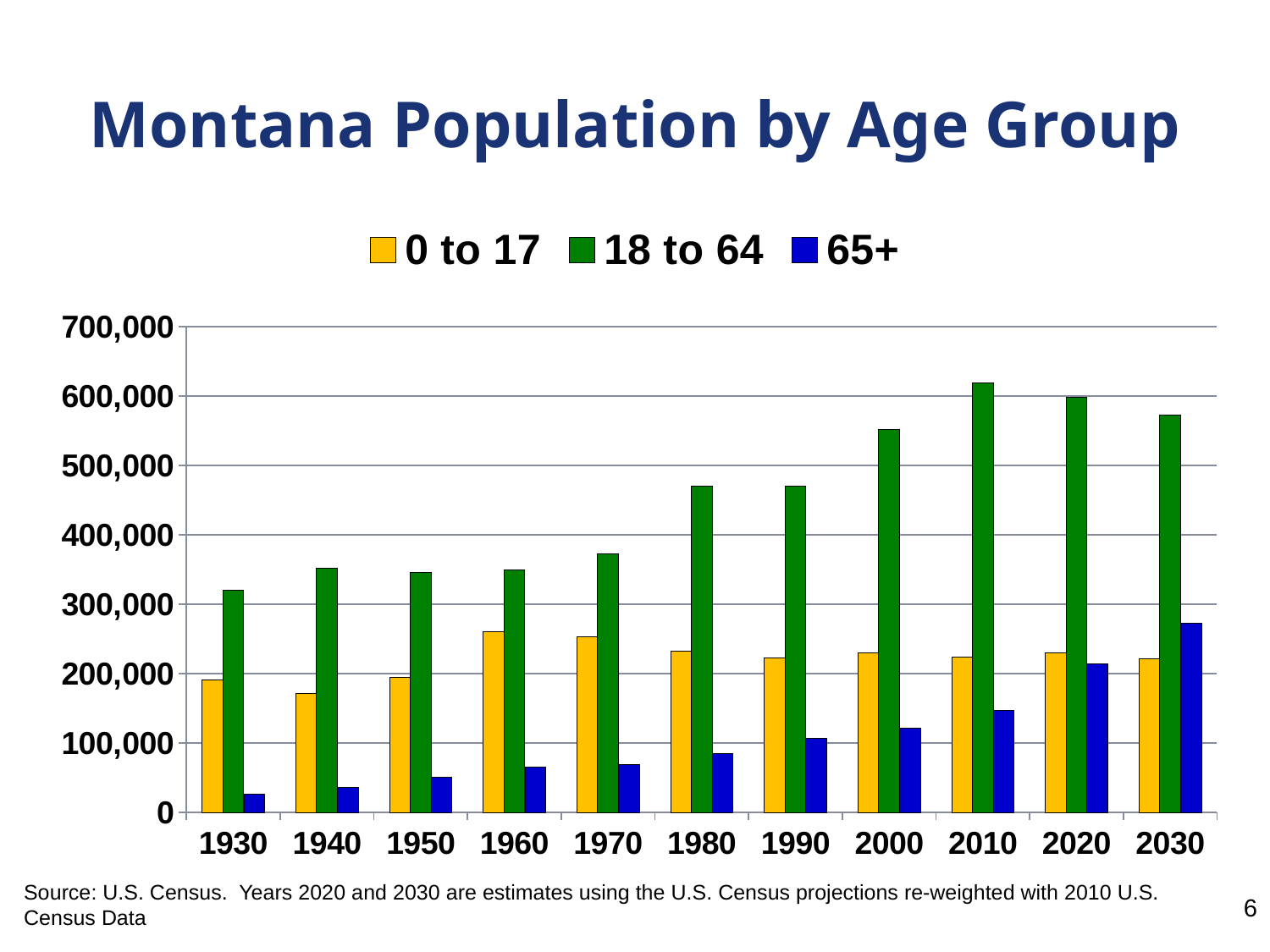
What kind of chart is shown on the slide? bar chart In which year is the 65+ population lowest? 1930 In which year is the 0 to 17 population lowest? 1940 How many years are shown along the x axis? 11 In 1930, which is larger: the 0 to 17 population or the 18 to 64 population? 18 to 64 What is the title of the chart? Montana Population by Age Group Is the 65+ value for 2030 greater or less than 200,000? greater How many series does the legend list? 3 Is the 18 to 64 value for 2010 greater or less than 600,000? greater Does the 65+ population rise or fall from 1930 to 2030? rise In which year is the 18 to 64 population highest? 2010 In which year is the 65+ population highest? 2030